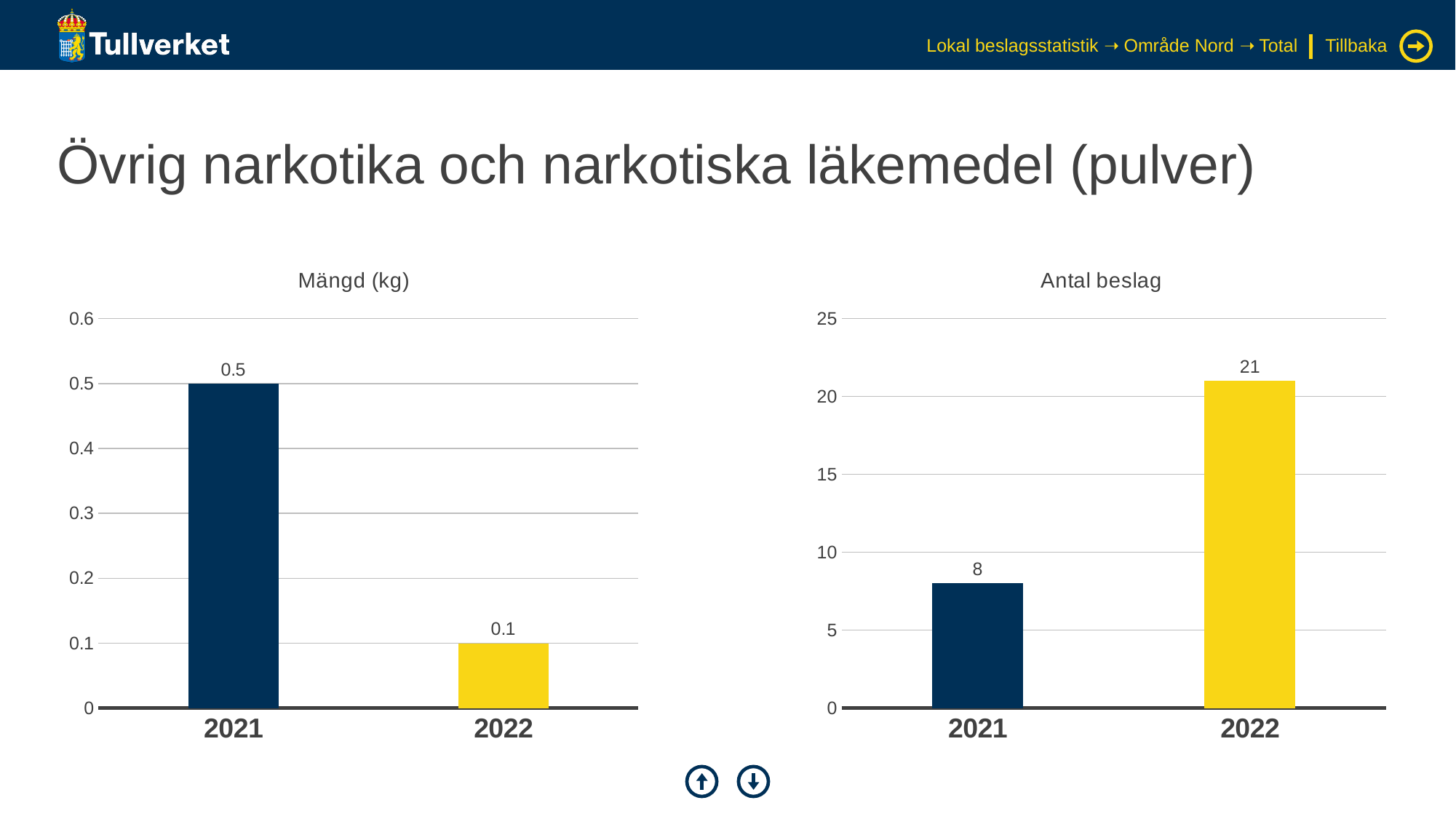
In the 'Mängd (kg)' chart, which year has the lowest value? 2022 In the 'Mängd (kg)' chart, what is the value for 2021? 0.5 In the 'Antal beslag' chart, what is the value for 2021? 8 What kind of chart is the 'Mängd (kg)' chart? bar chart In the 'Antal beslag' chart, what is the difference between the values for 2022 and 2021? 13 In the 'Mängd (kg)' chart, what is the difference between the values for 2021 and 2022? 0.4 How many categories are shown in the 'Antal beslag' chart? 2 In the 'Mängd (kg)' chart, what is the value for 2022? 0.1 In the 'Antal beslag' chart, which year has the highest value? 2022 In the 'Antal beslag' chart, is the value for 2022 greater or less than 20? greater In the 'Mängd (kg)' chart, which is larger, the value for 2021 or 2022? 2021 In the 'Antal beslag' chart, what is the value for 2022? 21